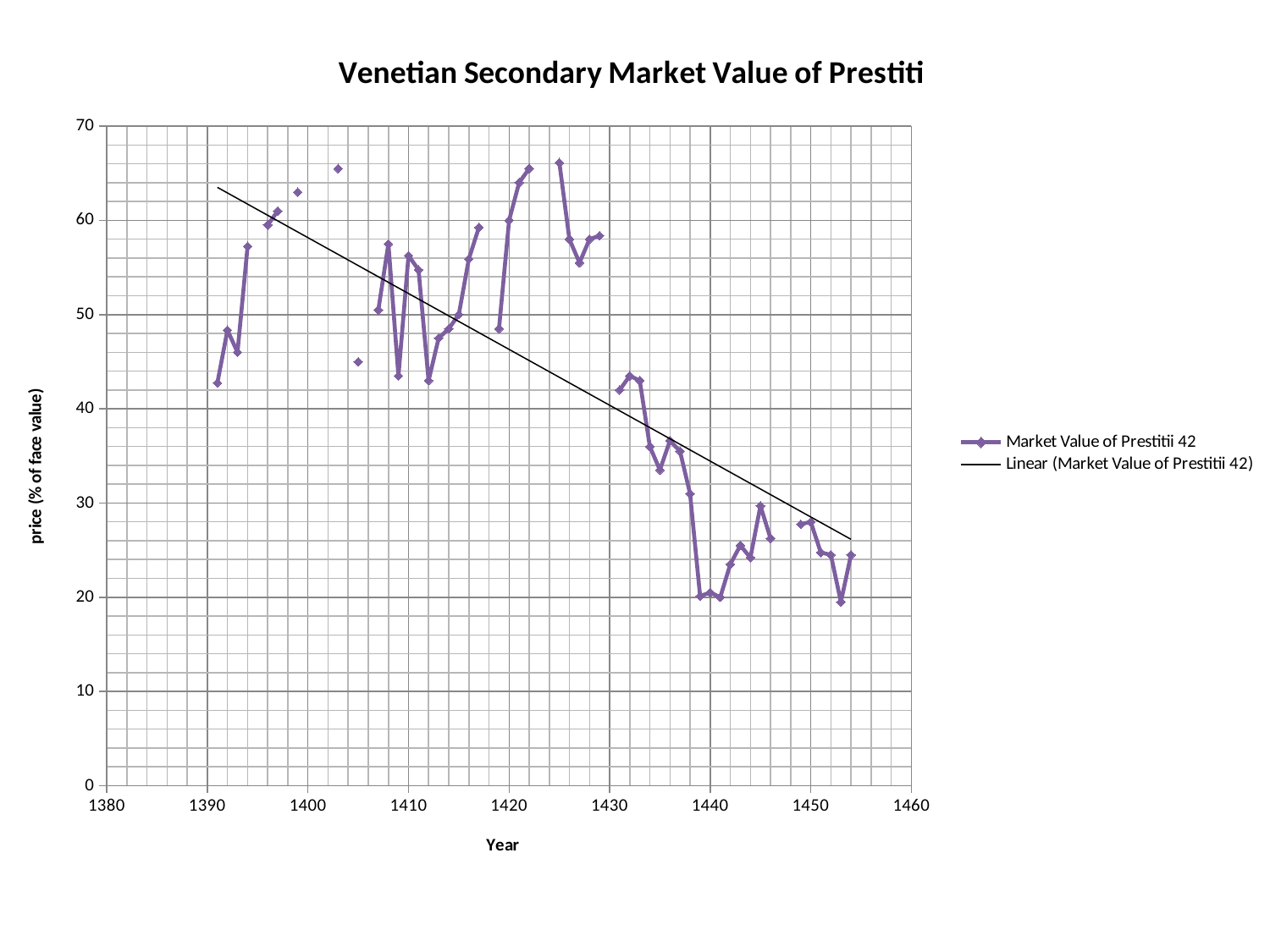
Is the market value for the year 1449 greater or less than 30? less Is the market value for the year 1405 greater or less than 50? less What is the title of the chart? Venetian Secondary Market Value of Prestiti Is the market value for the year 1425 greater or less than 60? greater What is the label of the vertical axis? price (% of face value) How many entries does the chart legend list? 2 Overall, do the market values rise or fall as the years increase from 1390 to 1454? fall Which year has the larger market value, 1425 or 1453? 1425 Which year has the larger market value, 1391 or 1403? 1403 What kind of chart is shown on the slide? line chart